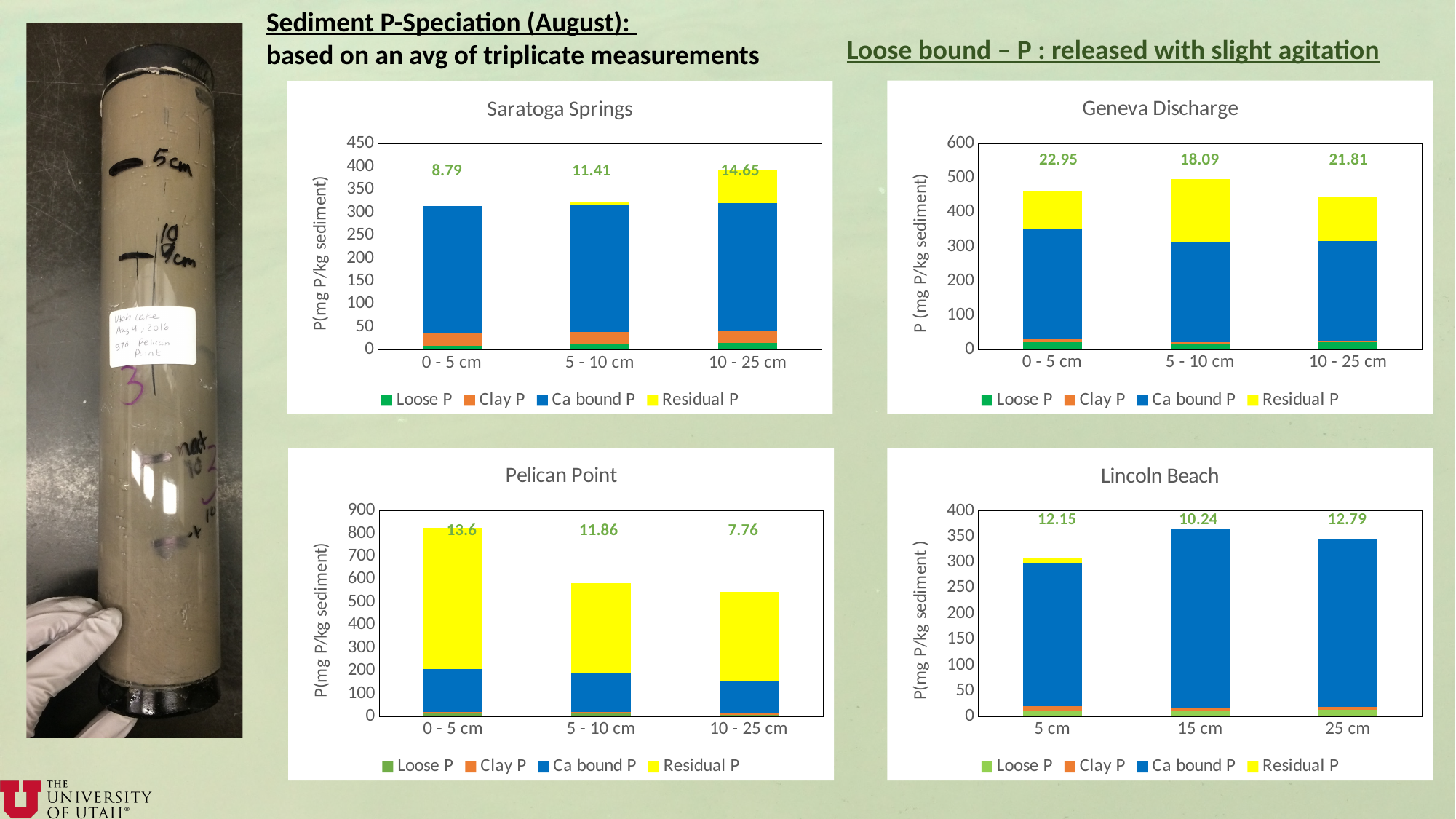
In the Pelican Point chart, what value is printed above the 10 - 25 cm bar? 7.76 In the Saratoga Springs chart, what is the difference between the printed values for 10 - 25 cm and 0 - 5 cm? 5.86 In the Pelican Point chart, which depth has the tallest stacked bar? 0 - 5 cm In the Geneva Discharge chart, what value is printed above the 5 - 10 cm bar? 18.09 In the Lincoln Beach chart, which printed value is larger, the one for 5 cm or the one for 15 cm? 5 cm In the Pelican Point chart, which depth has the lowest printed value above its bar? 10 - 25 cm What kind of chart is the Lincoln Beach chart? Stacked bar chart How many series does the legend of the Geneva Discharge chart list? 4 In the Geneva Discharge chart, which depth has the highest printed value above its bar? 0 - 5 cm In the Lincoln Beach chart, what value is printed above the 25 cm bar? 12.79 In the Saratoga Springs chart, what value is printed above the 0 - 5 cm bar? 8.79 In the Pelican Point chart, is the total height of the 0 - 5 cm stacked bar greater or less than 800? greater